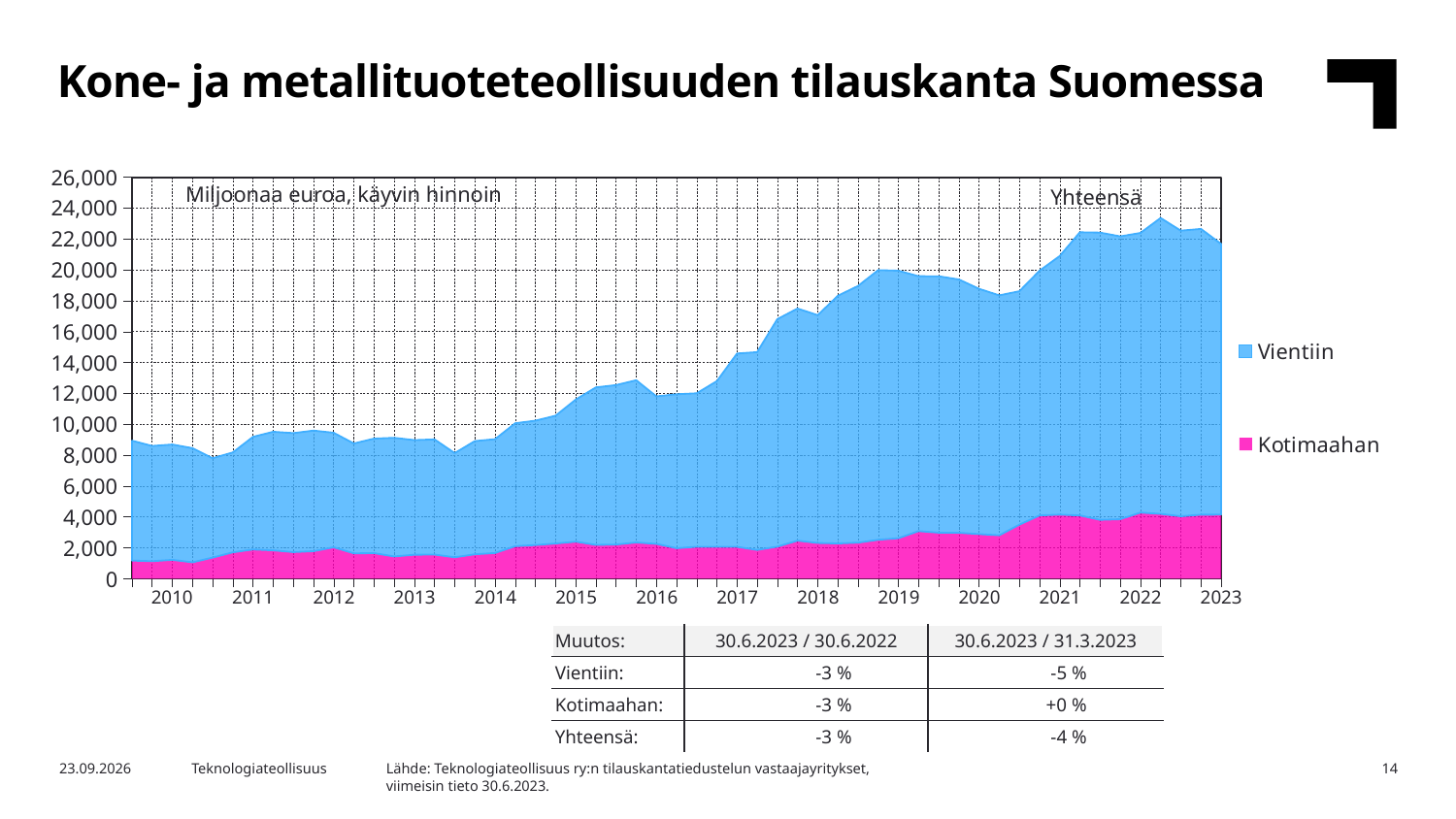
Is the total (Yhteensä) order book at the start of 2010 greater or less than 10,000? less How many year labels are shown on the x axis? 14 Is the total (Yhteensä) order book at the 2023 end of the chart greater or less than 20,000? greater Which two series are listed in the chart legend? Vientiin and Kotimaahan How many series does the chart legend list? 2 Is the Kotimaahan value at the start of 2010 greater or less than 2,000? less What unit is stated in the text inside the chart area? Miljoonaa euroa, käyvin hinnoin What kind of chart is shown on the slide? Stacked area chart Which series is larger throughout the chart, Vientiin or Kotimaahan? Vientiin Does the total order book generally rise or fall from 2010 to 2023? Rise